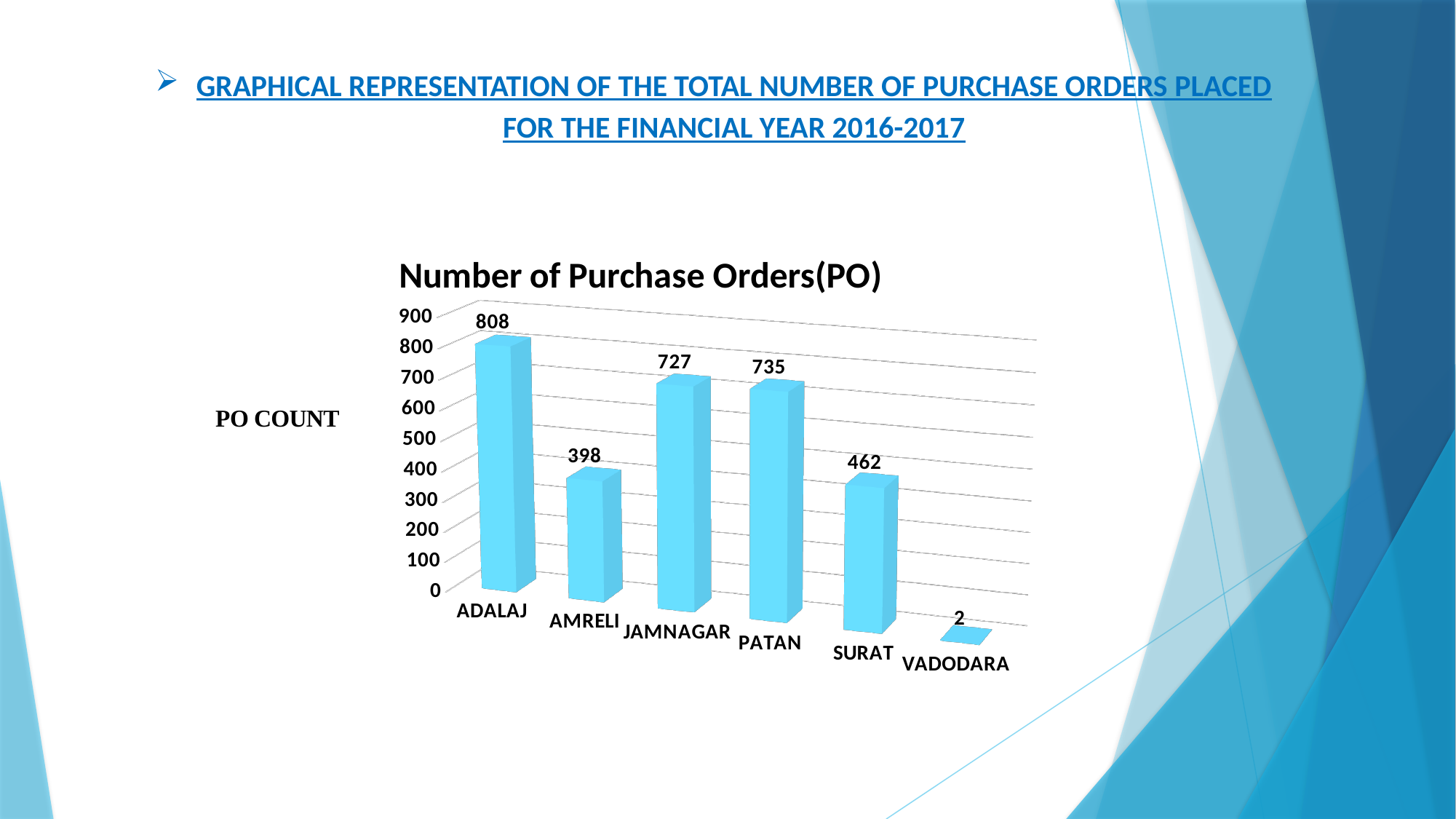
What is the difference between the purchase orders for PATAN and JAMNAGAR? 8 Which location has the highest number of purchase orders? ADALAJ Which has more purchase orders, SURAT or AMRELI? SURAT Which location has the lowest number of purchase orders? VADODARA What is the number of purchase orders for AMRELI? 398 What is the title of the chart? Number of Purchase Orders(PO) How many locations are shown on the chart? 6 What is the number of purchase orders for SURAT? 462 What kind of chart is shown on the slide? Bar chart What is the number of purchase orders for VADODARA? 2 What is the number of purchase orders for ADALAJ? 808 What is the difference between the purchase orders for ADALAJ and AMRELI? 410